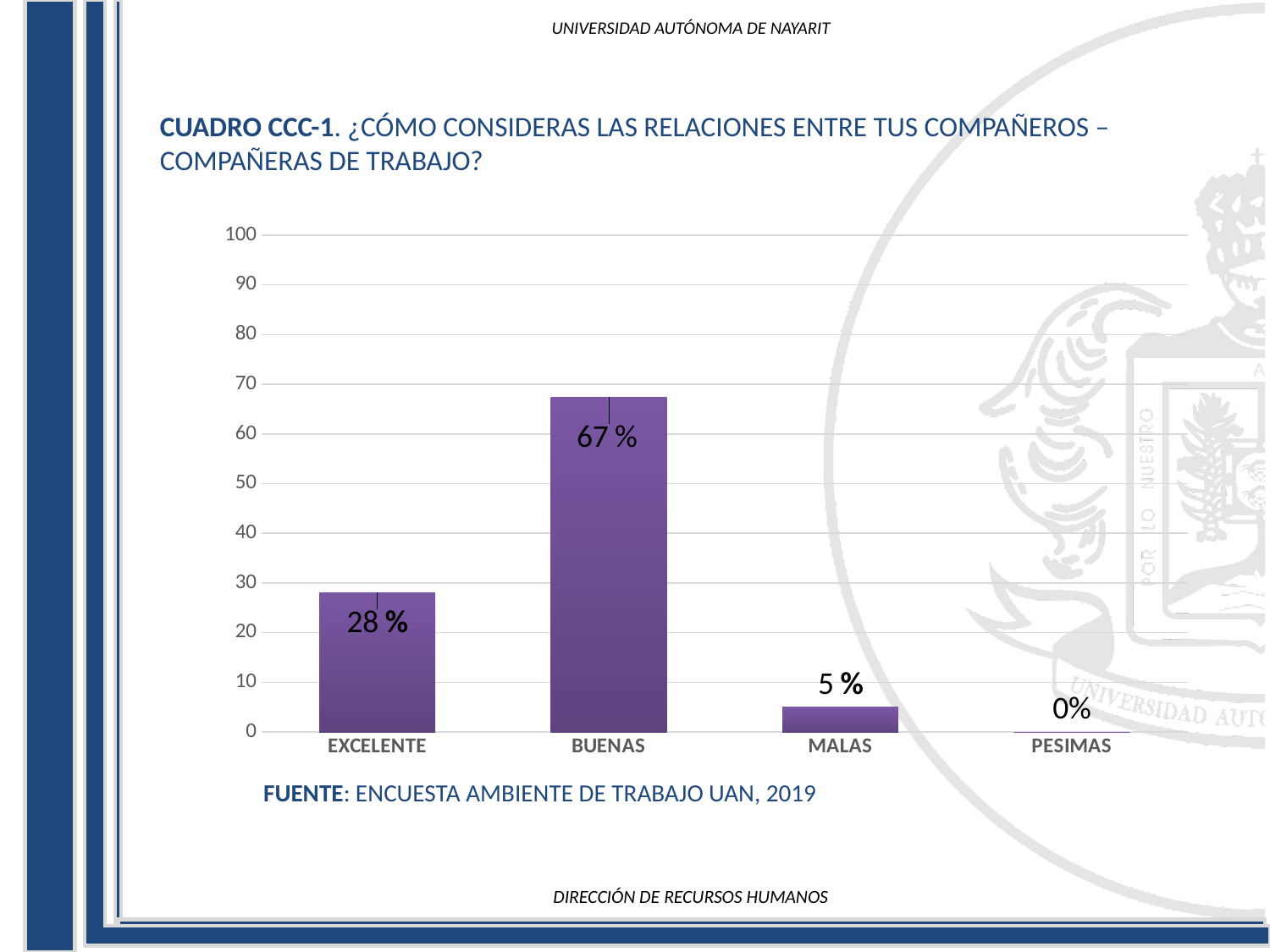
What kind of chart is shown on the slide? bar chart What is the value for BUENAS? 67 % What is the value for PESIMAS? 0% Which is larger, the value for EXCELENTE or the value for MALAS? EXCELENTE Which category has the highest value? BUENAS What is the source cited below the chart? ENCUESTA AMBIENTE DE TRABAJO UAN, 2019 What is the value for EXCELENTE? 28 % How many categories are shown on the x axis? 4 What is the value for MALAS? 5 % What is the difference between the values for BUENAS and EXCELENTE? 39 % Which category has the lowest value? PESIMAS Is the value for BUENAS greater or less than 60? greater